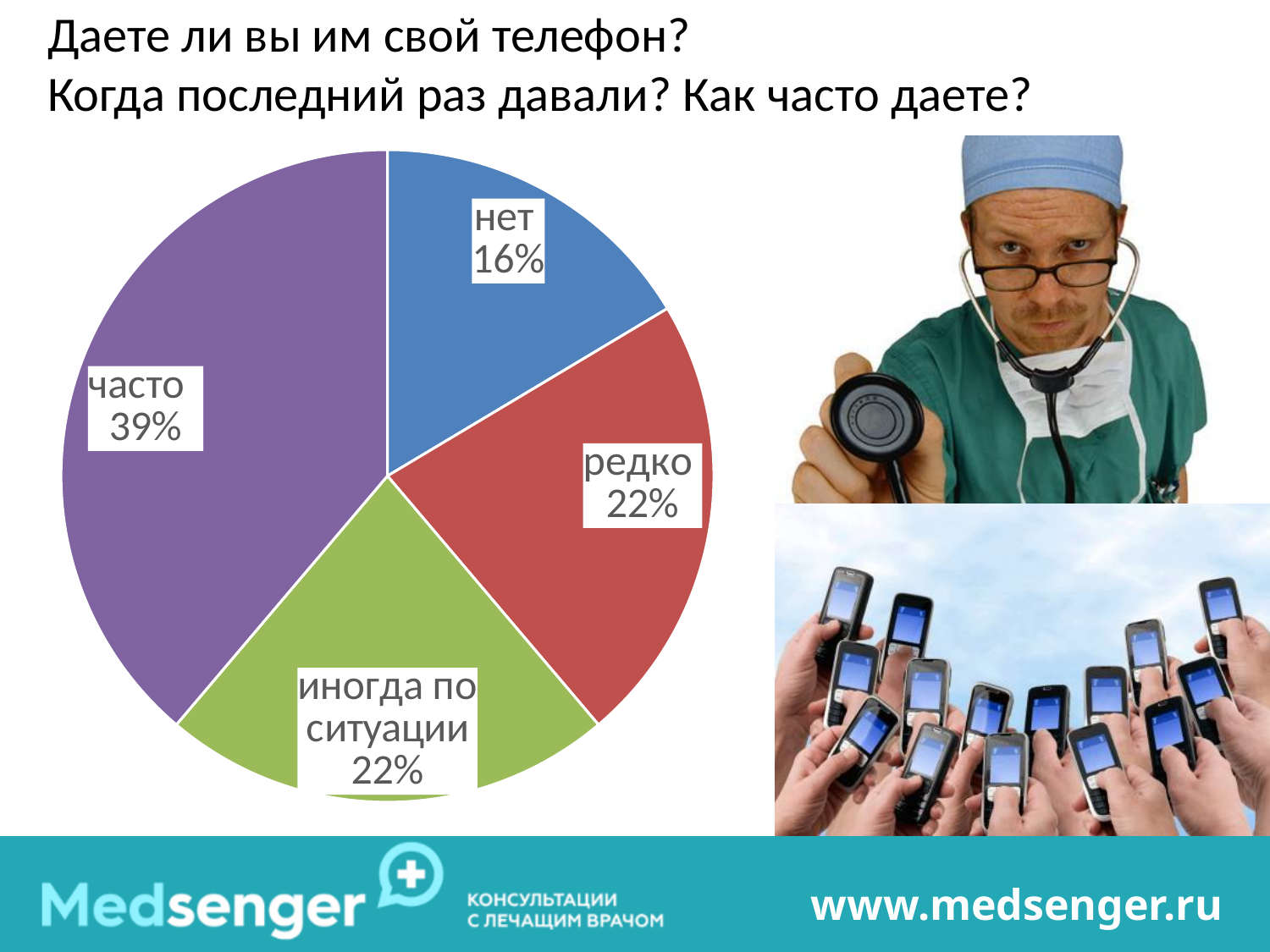
What is the difference between the "редко" and "нет" slices? 6% What is the value shown for the "нет" slice? 16% What is the difference between the "часто" and "нет" slices? 23% What is the value shown for the "редко" slice? 22% Which slice of the pie is the smallest? нет How many slices does the pie chart have? 4 Which slice of the pie is the largest? часто What is the value shown for the "иногда по ситуации" slice? 22% What colour is the "часто" slice of the pie? purple What share of the pie does the "часто" slice represent? 39% Which is larger, the "часто" slice or the "редко" slice? часто What kind of chart is shown on the slide? pie chart